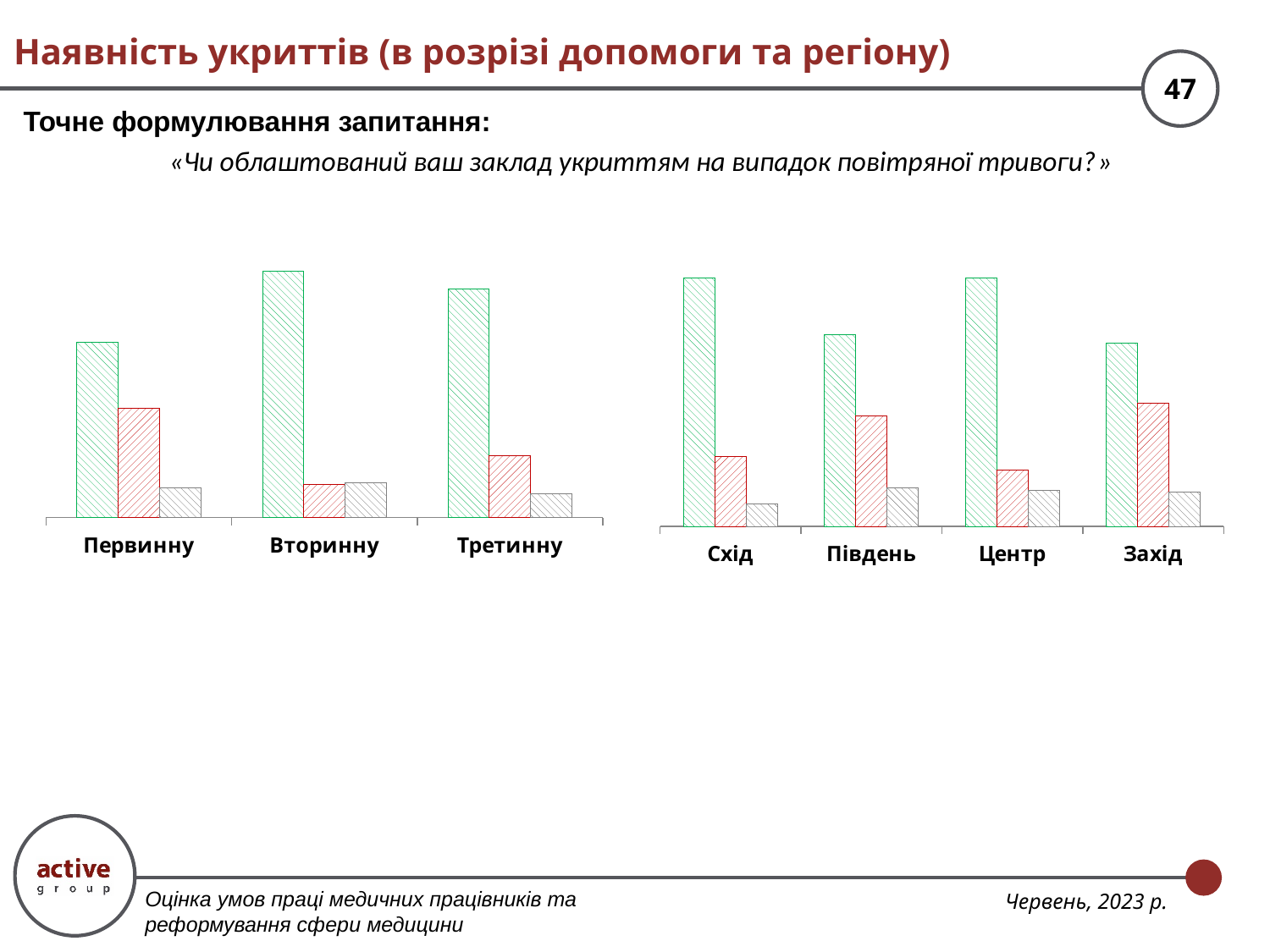
How many bars are shown for each category in the right chart? 3 What kind of chart is the left chart with categories Первинну, Вторинну and Третинну? bar chart In the left chart, which category has the tallest red hatched bar? Первинну In the left chart, is the red hatched bar for Первинну taller or shorter than the red hatched bar for Вторинну? taller In the left chart, which category has the tallest green hatched bar? Вторинну In the left chart, which category has the shortest green hatched bar? Первинну In the right chart, is the red hatched bar for Захід taller or shorter than the red hatched bar for Схід? taller What kind of chart is the right chart with categories Схід, Південь, Центр and Захід? bar chart How many categories are shown on the x axis of the left chart? 3 In the right chart, is the green hatched bar for Центр taller or shorter than the green hatched bar for Захід? taller How many categories are shown on the x axis of the right chart? 4